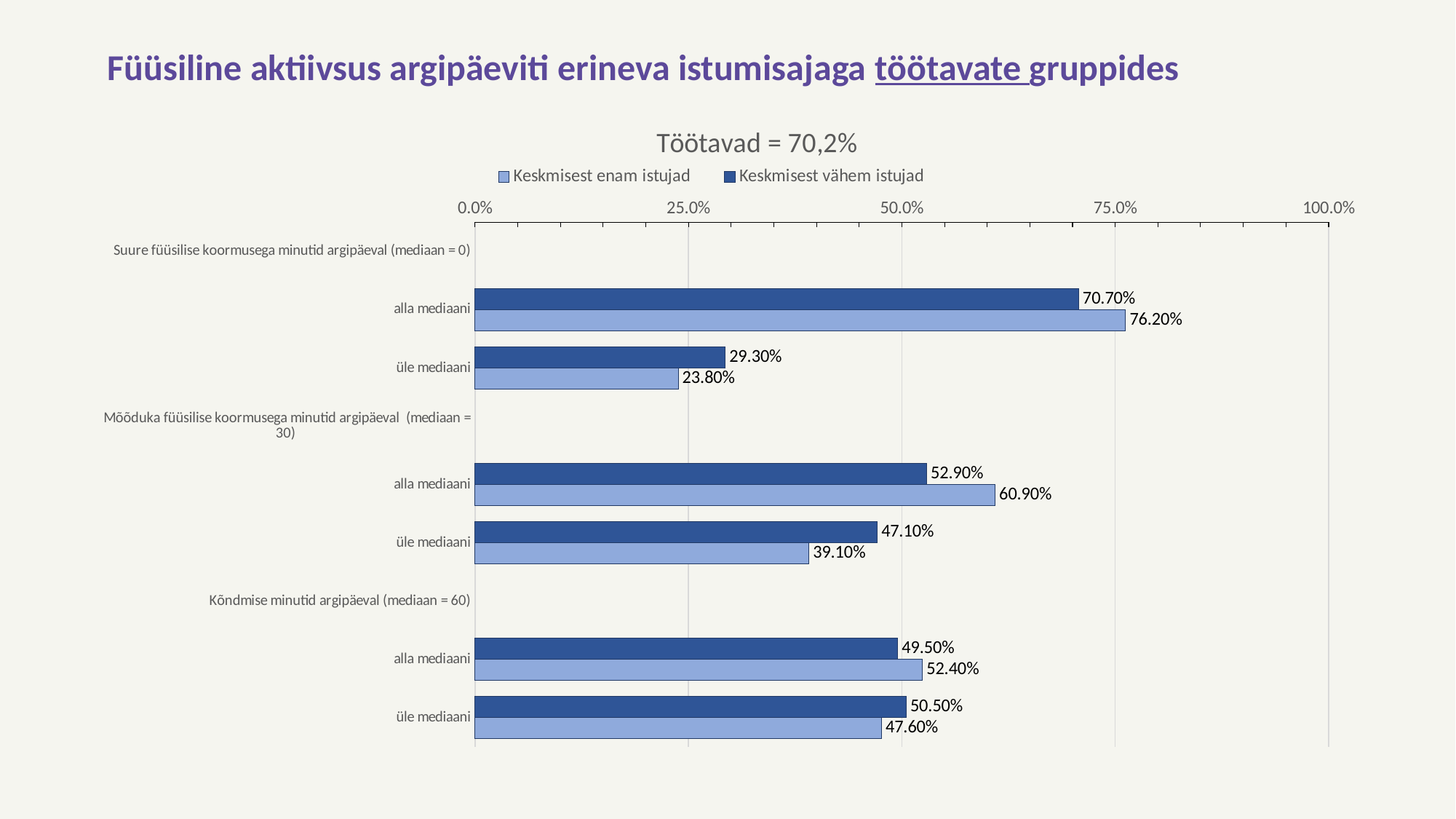
What kind of chart is shown on the slide? bar chart What is the value for 'Keskmisest enam istujad' in the 'üle mediaani' row under 'Mõõduka füüsilise koormusega minutid argipäeval (mediaan = 30)'? 39.10% What is the value for 'Keskmisest enam istujad' in the 'alla mediaani' row under 'Suure füüsilise koormusega minutid argipäeval (mediaan = 0)'? 76.20% Which bar has the lowest value in the chart? Keskmisest enam istujad, üle mediaani (Suure füüsilise koormusega minutid argipäeval) What is the title shown above the chart? Töötavad = 70,2% What is the value for 'Keskmisest vähem istujad' in the 'üle mediaani' row under 'Suure füüsilise koormusega minutid argipäeval (mediaan = 0)'? 29.30% Which bar has the highest value in the chart? Keskmisest enam istujad, alla mediaani (Suure füüsilise koormusega minutid argipäeval) In the 'üle mediaani' row under 'Kõndmise minutid argipäeval (mediaan = 60)', which series has the larger value? Keskmisest vähem istujad How many series does the legend list? 2 What is the difference between 'Keskmisest enam istujad' and 'Keskmisest vähem istujad' in the 'alla mediaani' row under 'Mõõduka füüsilise koormusega minutid argipäeval (mediaan = 30)'? 8.00% What is the value for 'Keskmisest vähem istujad' in the 'alla mediaani' row under 'Kõndmise minutid argipäeval (mediaan = 60)'? 49.50% Is the value for 'Keskmisest vähem istujad' in the 'alla mediaani' row under 'Suure füüsilise koormusega minutid argipäeval (mediaan = 0)' greater or less than 50.0%? greater